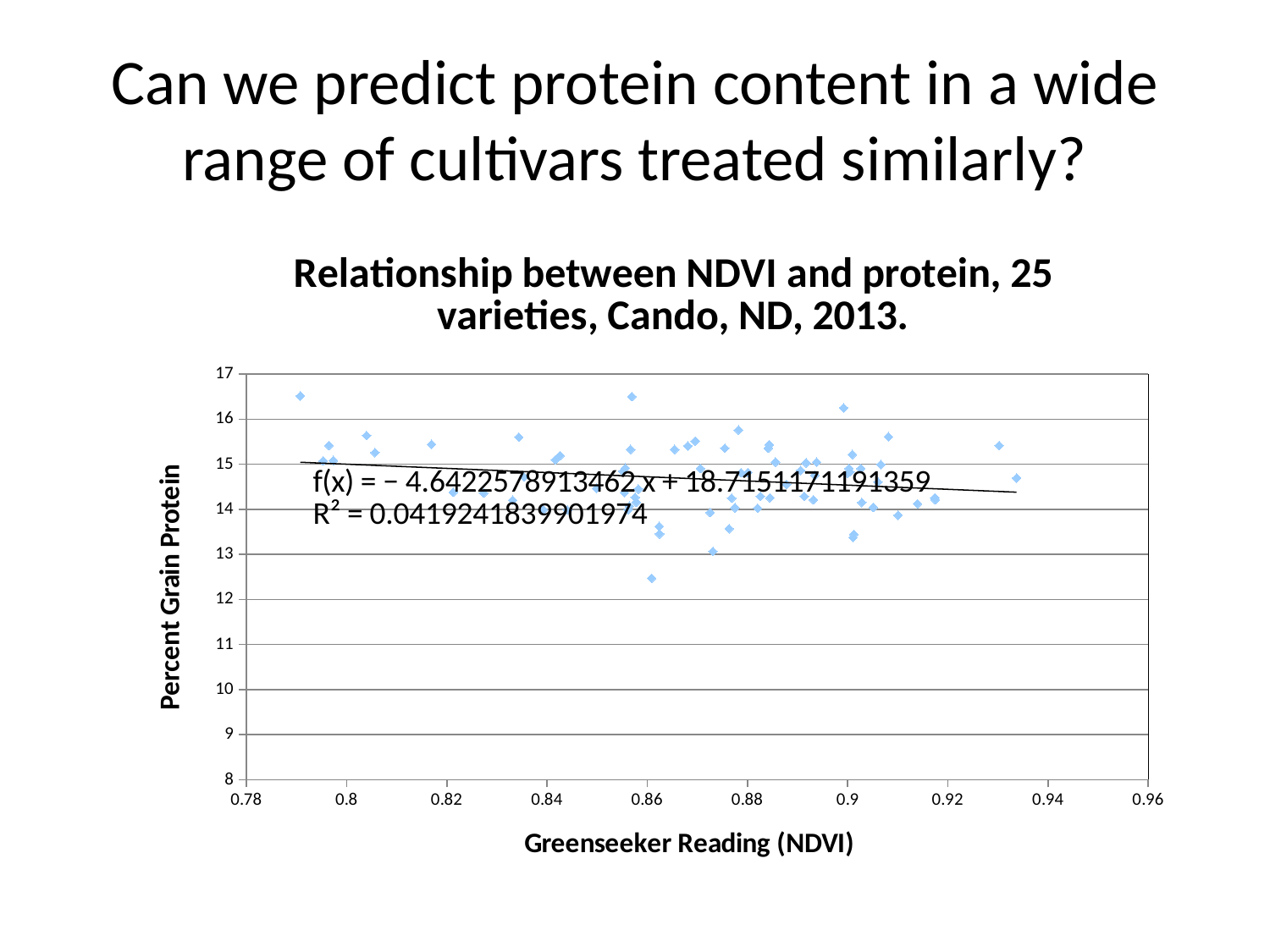
How many varieties does the chart title say are included? 25 What is the R² value shown on the chart? 0.0419241839901974 What is the intercept of the fitted line f(x) shown on the chart? 18.7151171191359 What kind of chart is shown on the slide? Scatter plot What is the title of the chart? Relationship between NDVI and protein, 25 varieties, Cando, ND, 2013. Is the protein value of the lowest point on the chart greater or less than 13? less Does the fitted trendline rise or fall as NDVI increases? Fall Is the protein value of the highest point on the chart greater or less than 16? greater What is the maximum value shown on the y axis? 17 What is the minimum value shown on the x axis? 0.78 What is the label of the x axis? Greenseeker Reading (NDVI) What is the slope of the fitted line f(x) shown on the chart? − 4.6422578913462